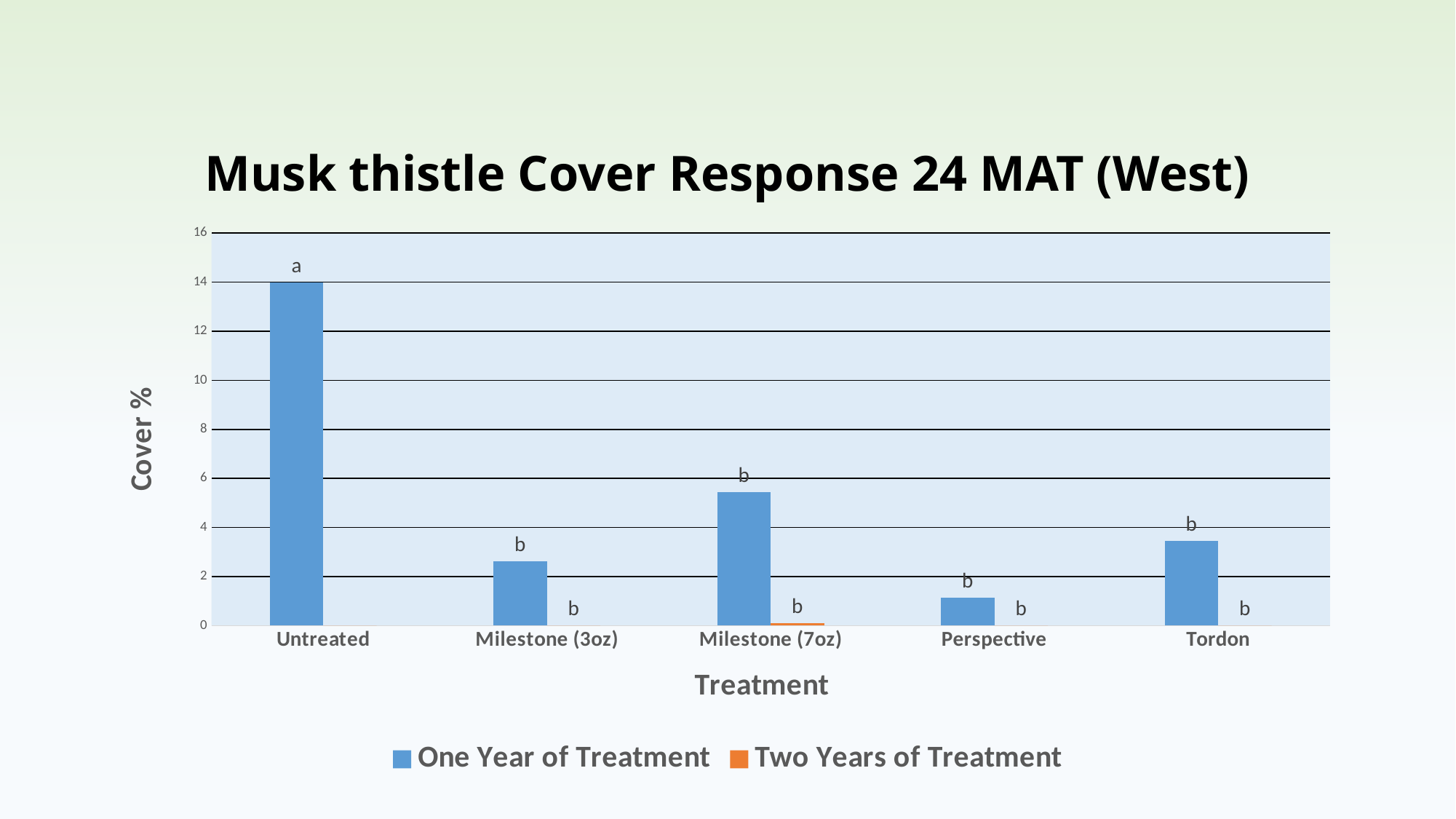
Which treatment has the lowest One Year of Treatment cover? Perspective Which treatment has the highest One Year of Treatment cover? Untreated Is the One Year of Treatment value for Untreated greater or less than 10? greater What is the title of the y axis? Cover % Is the One Year of Treatment value for Milestone (7oz) greater or less than 4? greater For One Year of Treatment, which is larger: Milestone (3oz) or Milestone (7oz)? Milestone (7oz) For One Year of Treatment, which is larger: Tordon or Perspective? Tordon What letter label is printed above the Untreated One Year of Treatment bar? a How many series does the legend list? 2 How many treatment categories are shown on the x axis? 5 What kind of chart is shown on the slide? bar chart Is the One Year of Treatment value for Perspective greater or less than 2? less